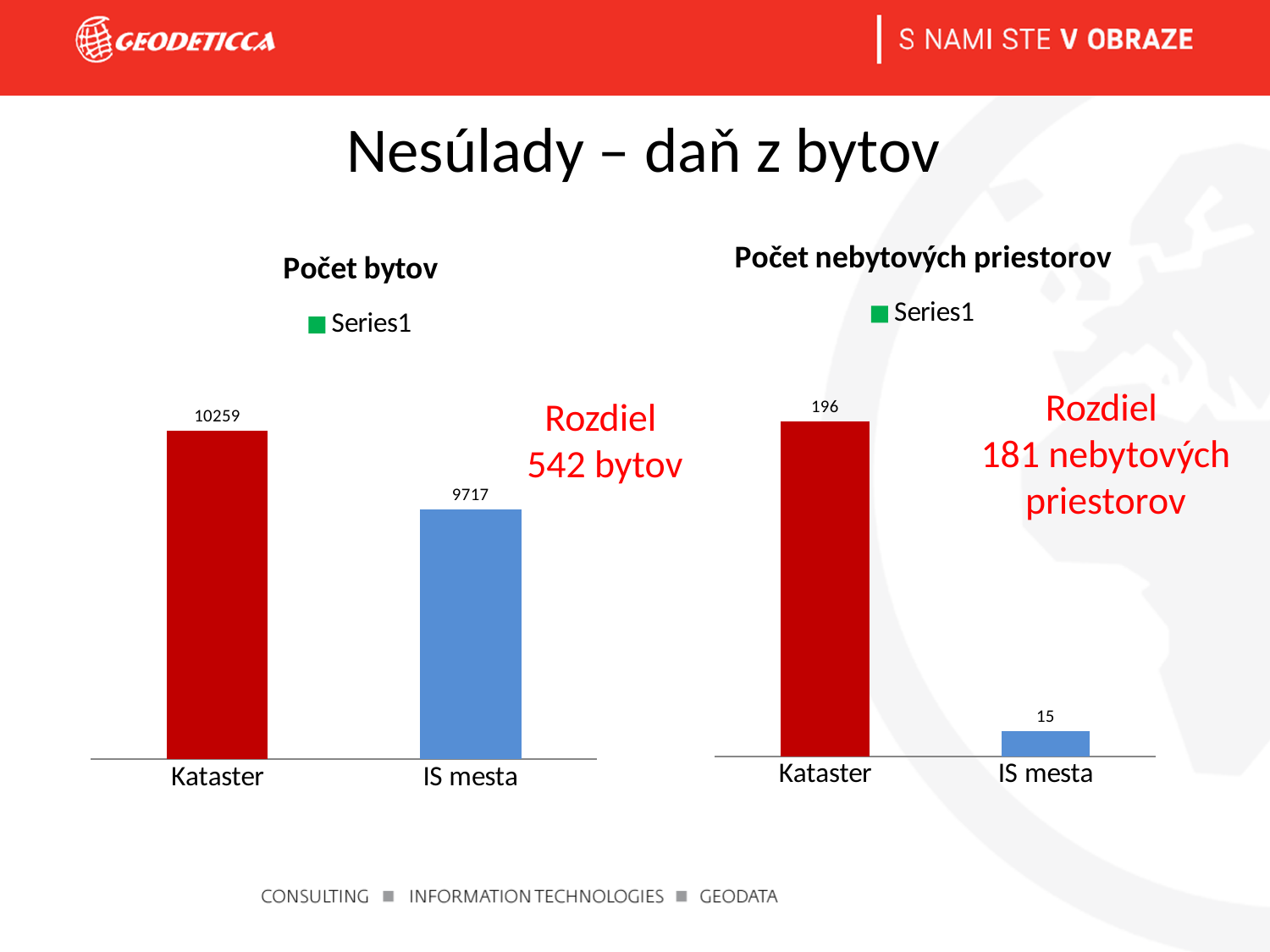
How many categories are shown in the 'Počet bytov' chart? 2 How many series does the legend of the 'Počet bytov' chart list? 1 What type of chart is the 'Počet nebytových priestorov' chart? Bar chart In the 'Počet nebytových priestorov' chart, is the value for Kataster or IS mesta larger? Kataster In the 'Počet nebytových priestorov' chart, what is the difference between the Kataster and IS mesta values? 181 In the 'Počet bytov' chart, which category has the higher value? Kataster In the 'Počet nebytových priestorov' chart, what is the value for IS mesta? 15 In the 'Počet bytov' chart, what is the difference between the Kataster and IS mesta values? 542 In the 'Počet nebytových priestorov' chart, which category has the lowest value? IS mesta In the 'Počet nebytových priestorov' chart, what is the value for Kataster? 196 In the 'Počet bytov' chart, what is the value for IS mesta? 9717 In the 'Počet bytov' chart, what is the value for Kataster? 10259